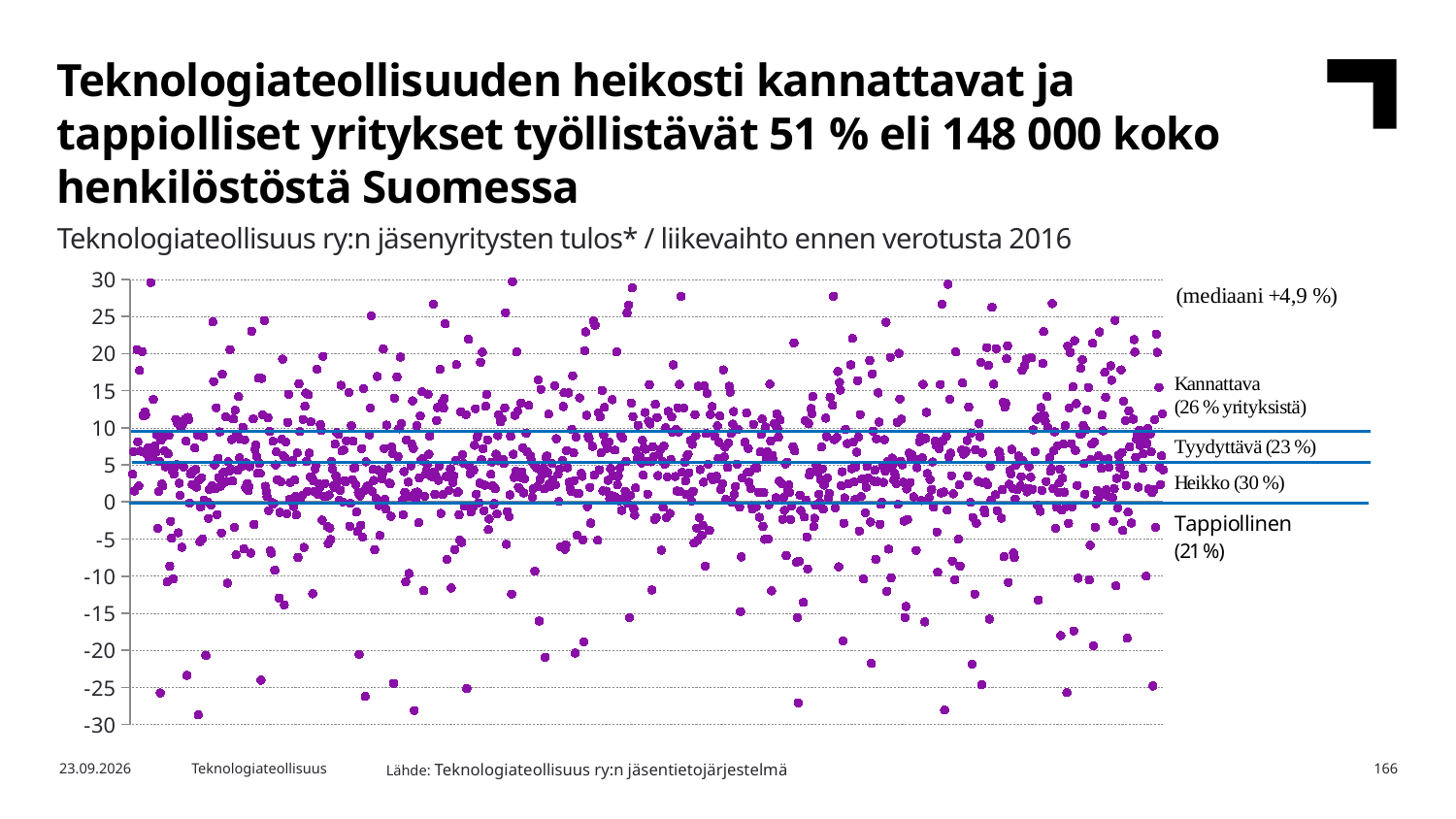
What share of companies is labelled Kannattava? 26 % What is the median value (mediaani) shown on the chart? +4,9 % What is the difference in percentage points between the Heikko share and the Tappiollinen share? 9 Which category has the largest share of companies? Heikko Which category has the smallest share of companies? Tappiollinen What share of companies is labelled Tyydyttävä? 23 % What share of companies is labelled Heikko? 30 % Which category has a larger share of companies, Kannattava or Tyydyttävä? Kannattava What share of companies is labelled Tappiollinen? 21 % What kind of chart is shown on the slide? Scatter chart How many profitability categories are labelled on the chart? 4 What is the highest value shown on the vertical axis? 30